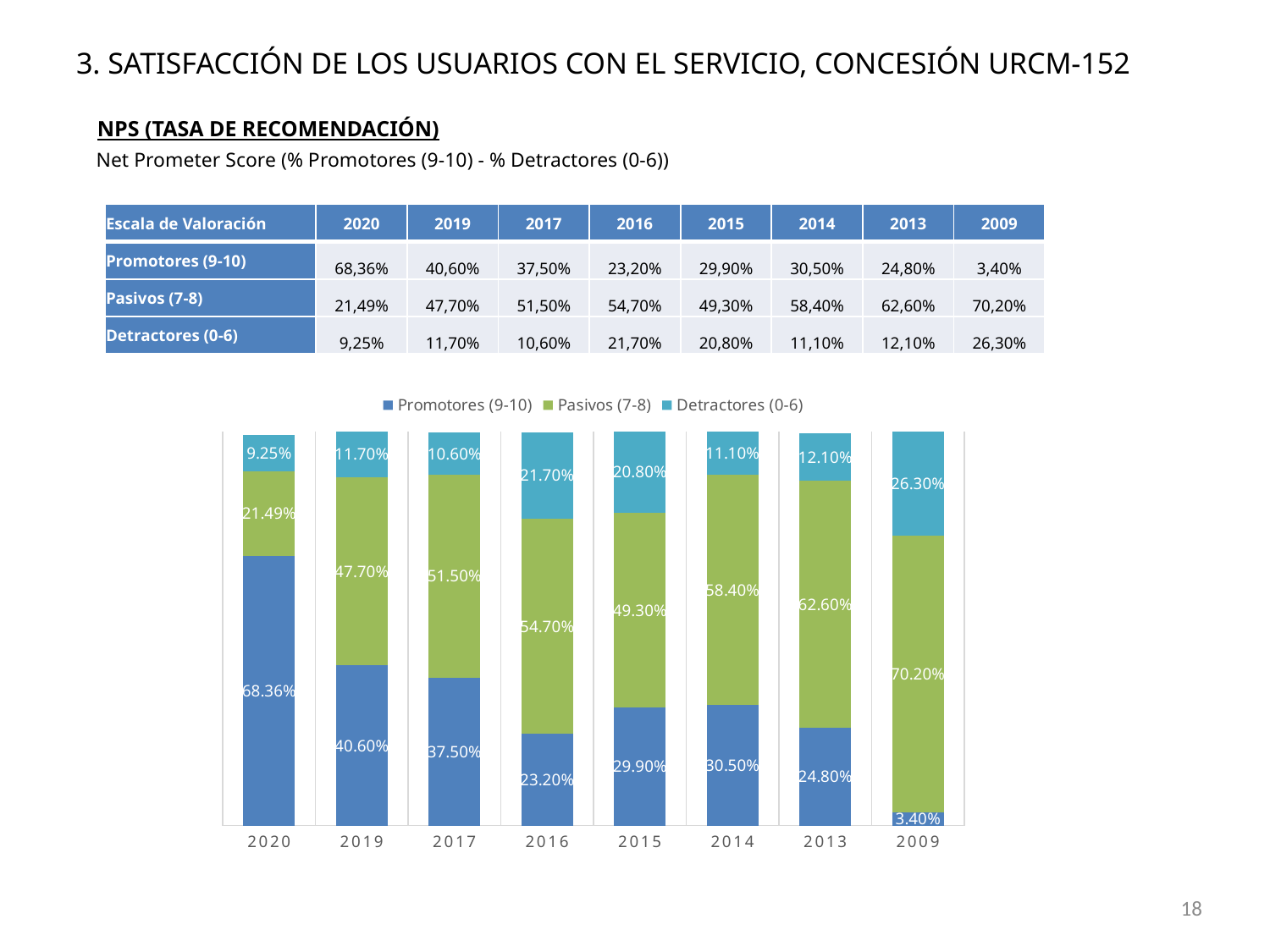
Which year has the lowest value for Promotores (9-10)? 2009 What is the value for Promotores (9-10) in 2020? 68.36% What is the total of the stacked bar for 2019? 100.00% How many series does the chart legend list? 3 What is the value for Detractores (0-6) in 2016? 21.70% What kind of chart is shown on the slide? Stacked bar chart What is the value for Pasivos (7-8) in 2009? 70.20% Which year has the highest value for Detractores (0-6)? 2009 Which is larger, the Pasivos (7-8) value for 2014 or for 2015? 2014 Which year has the highest value for Promotores (9-10)? 2020 How many years are shown on the x axis of the chart? 8 What is the difference between the Promotores (9-10) values for 2020 and 2019? 27.76%